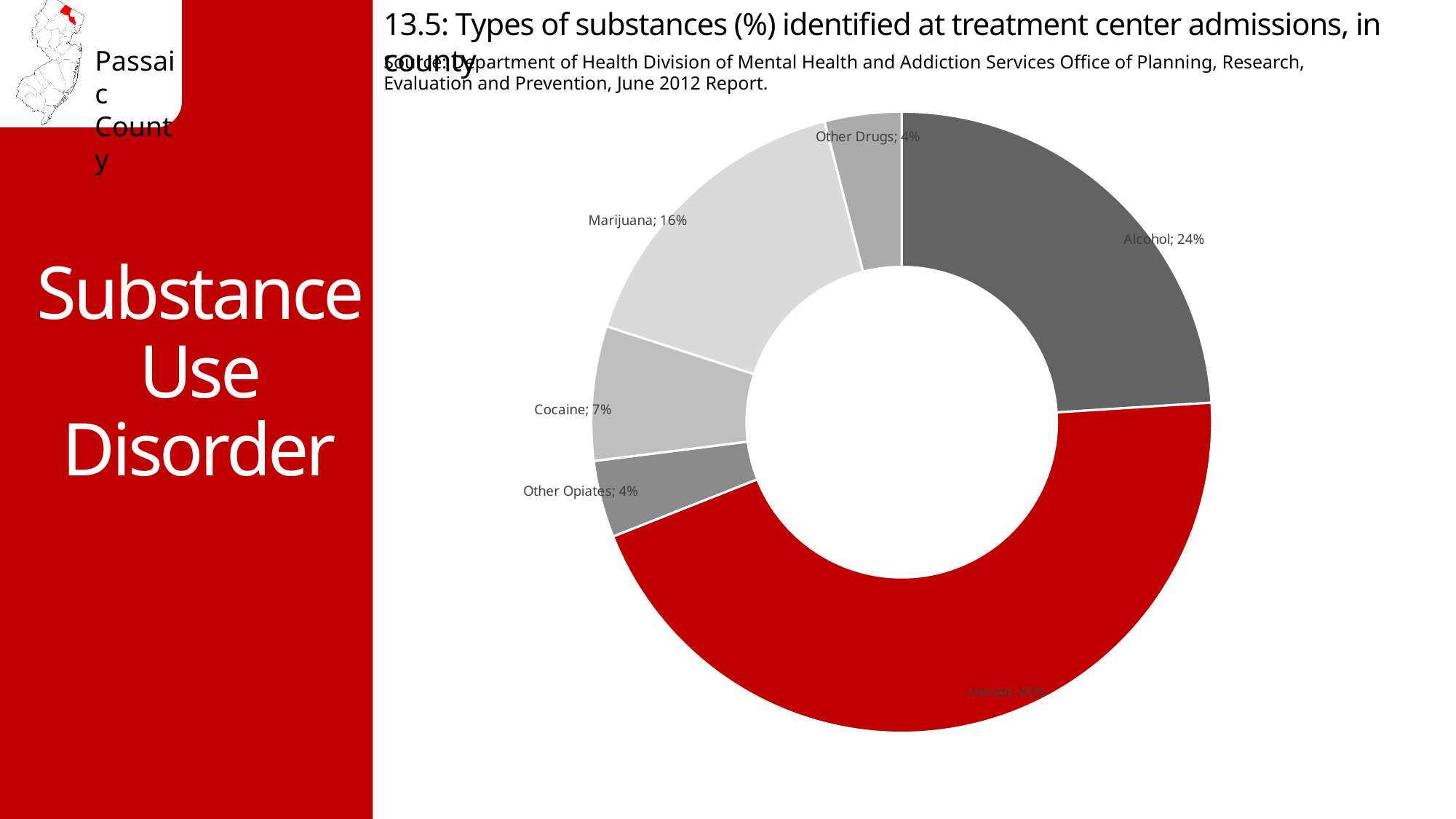
What percentage of treatment center admissions identified Alcohol? 24% Which is larger, the share for Marijuana or the share for Cocaine? Marijuana How many percentage points higher is Alcohol than Marijuana? 8 How many substance categories are shown in the chart? 6 What percentage is shown for Cocaine? 7% What colour is the Heroin slice of the chart? Red What kind of chart is shown on the slide? Doughnut (pie) chart What share of the chart does Heroin account for? 45% What percentage is shown for Marijuana? 16% Which substance has the largest share of treatment center admissions? Heroin What percentage is shown for Other Opiates? 4% How many percentage points higher is Heroin than Alcohol? 21